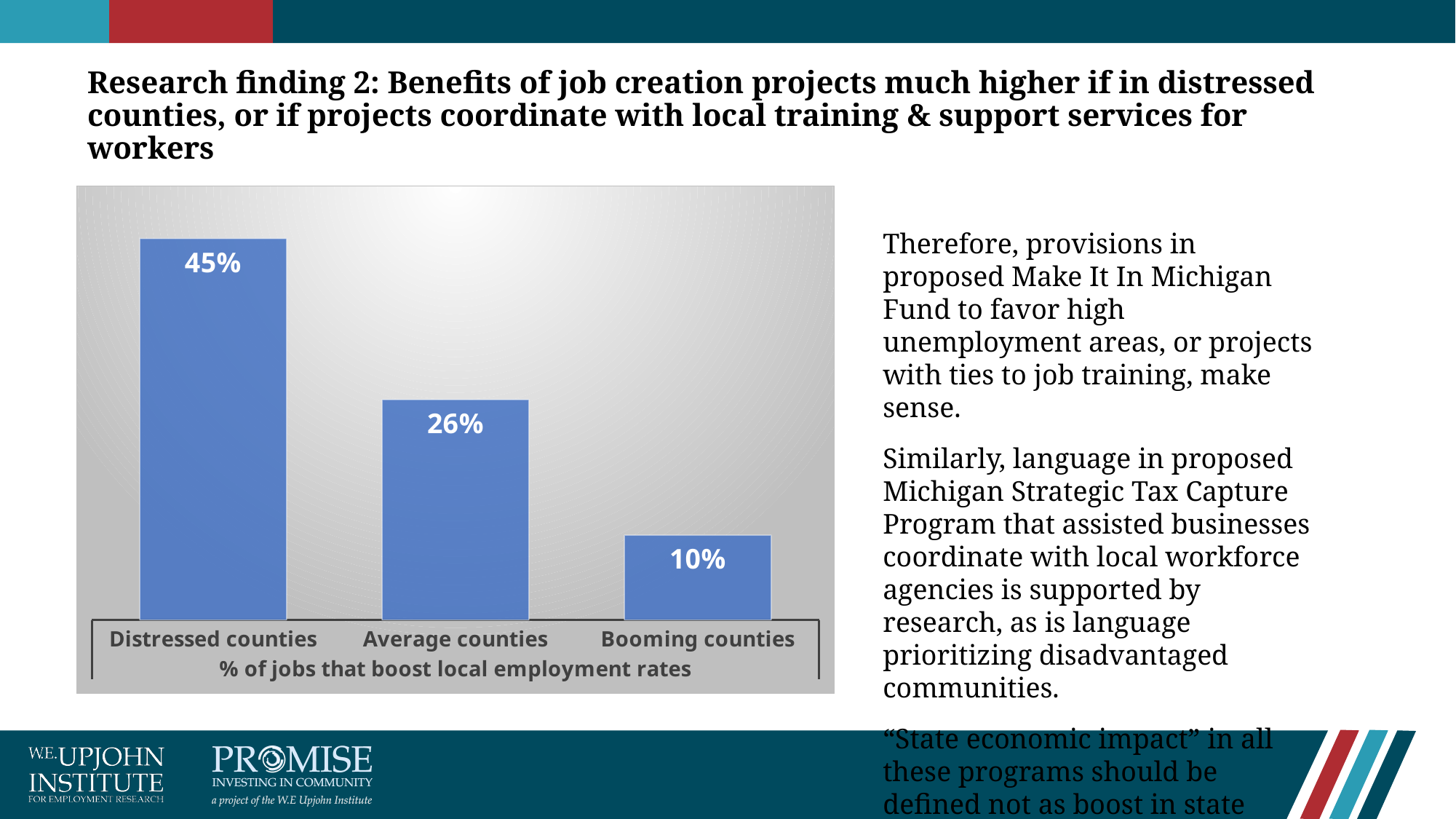
What is the label shown beneath the category axis of the chart? % of jobs that boost local employment rates What is the value for Booming counties? 10% Which is larger, the value for Average counties or the value for Booming counties? Average counties What is the difference between the values for Average counties and Booming counties? 16% What kind of chart is shown on the slide? Bar chart How many categories are shown in the chart? 3 Do the values rise or fall from left to right across the categories? Fall What is the difference between the values for Distressed counties and Average counties? 19% Which category has the highest value? Distressed counties What is the value for Distressed counties? 45% What is the value for Average counties? 26% Which category has the lowest value? Booming counties